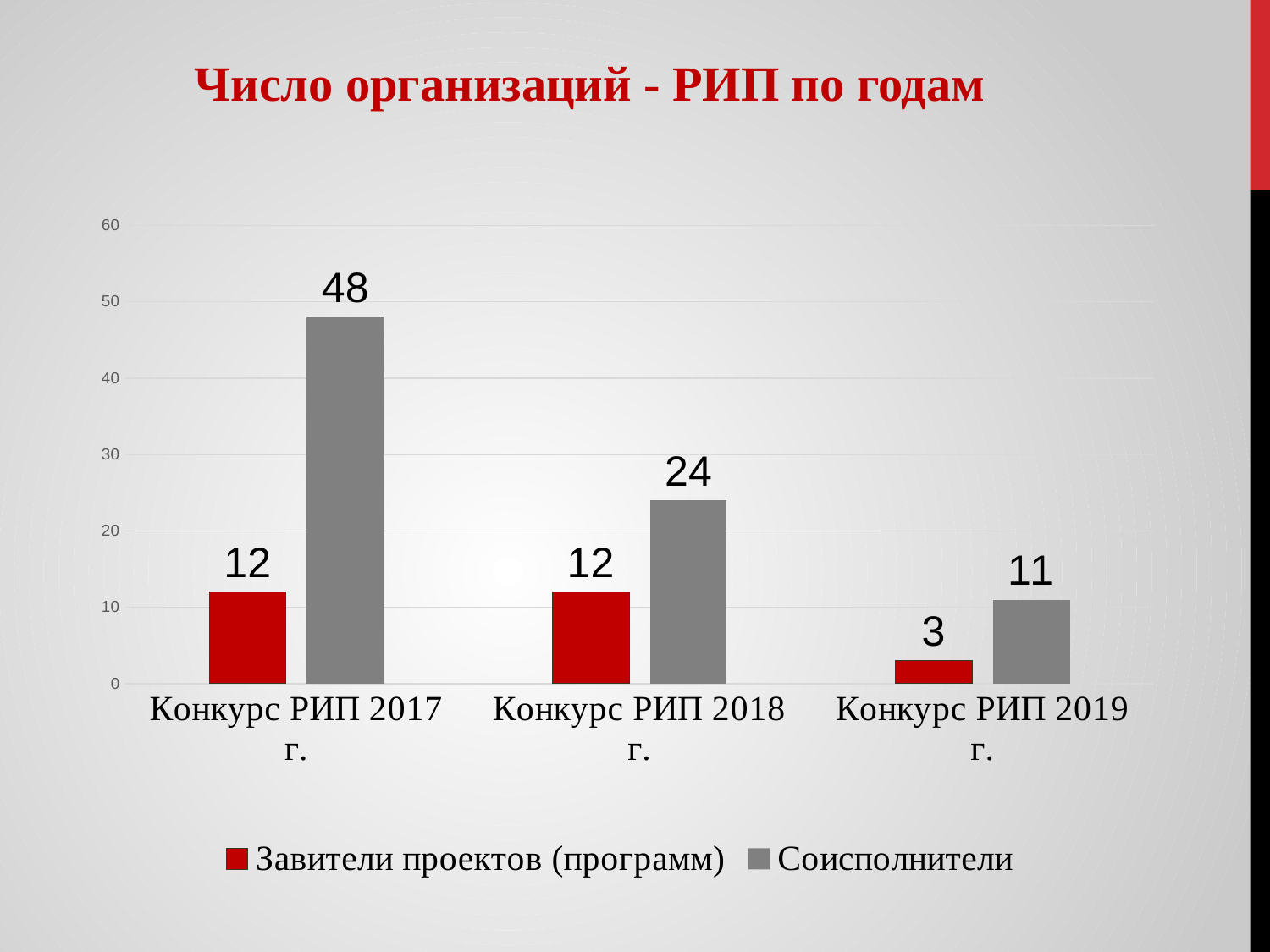
Which category has the highest value for Соисполнители? Конкурс РИП 2017 г. What kind of chart is shown on the slide? Bar chart What is the value for Соисполнители in Конкурс РИП 2018 г.? 24 How many categories are shown on the x axis? 3 Which is larger in Конкурс РИП 2019 г.: Завители проектов (программ) or Соисполнители? Соисполнители What is the difference between Соисполнители in Конкурс РИП 2018 г. and Конкурс РИП 2019 г.? 13 What is the difference between Соисполнители and Завители проектов (программ) in Конкурс РИП 2017 г.? 36 What is the value for Соисполнители in Конкурс РИП 2017 г.? 48 Do the values for Соисполнители rise or fall from Конкурс РИП 2017 г. to Конкурс РИП 2019 г.? Fall Which category has the lowest value for Завители проектов (программ)? Конкурс РИП 2019 г. How many series does the legend list? 2 What is the value for Завители проектов (программ) in Конкурс РИП 2019 г.? 3